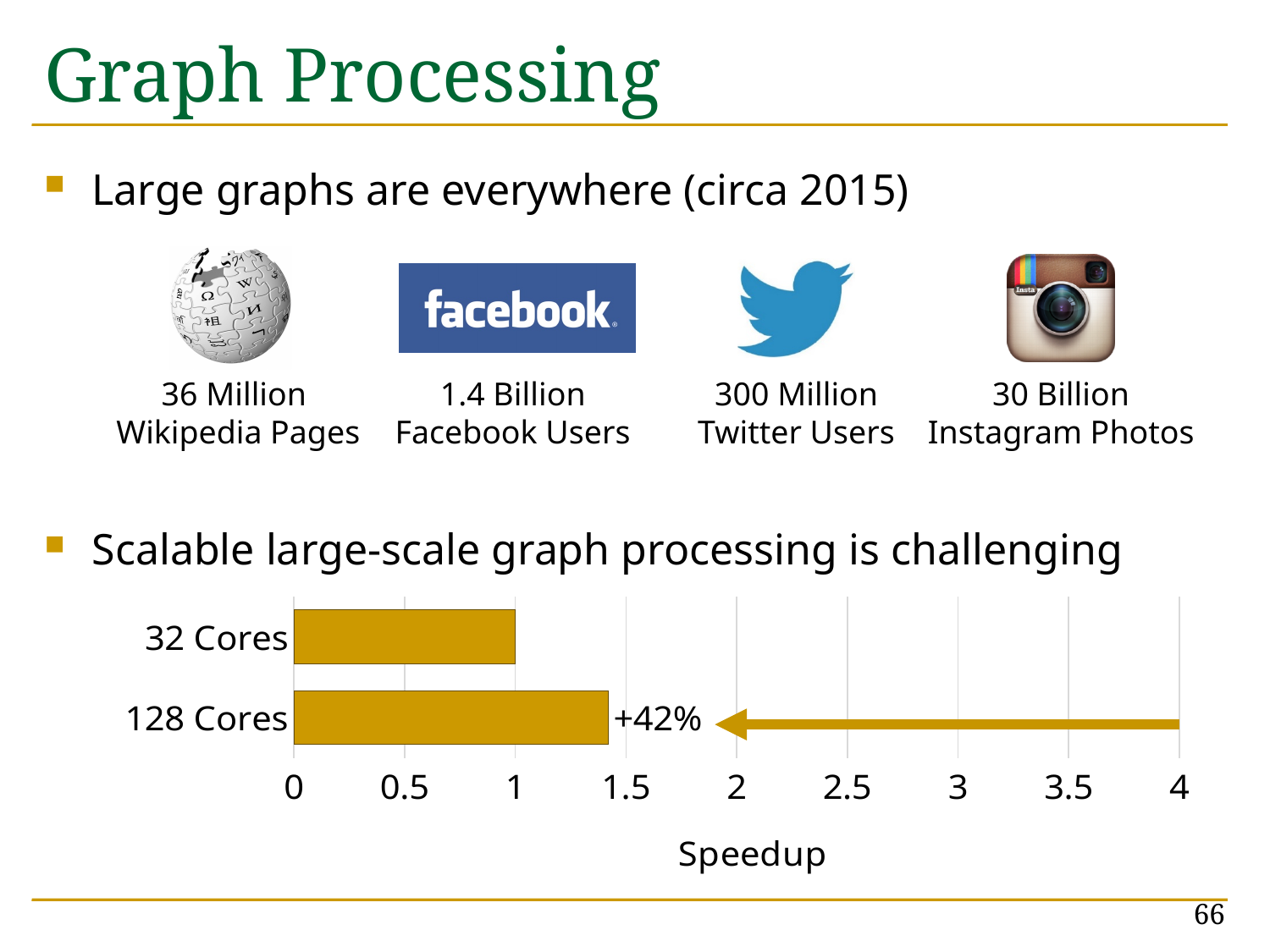
What annotation is printed next to the 128 Cores bar? +42% Is the speedup for 32 Cores greater or less than 2? less Which category has the higher speedup in the chart? 128 Cores Which is larger, the speedup for 128 Cores or for 32 Cores? 128 Cores What is the speedup value for 32 Cores? 1 How many categories are plotted in the Speedup chart? 2 Is the speedup for 128 Cores greater or less than 1.5? less What kind of chart is shown at the bottom of the slide? bar chart What is the title of the x axis in the chart? Speedup Which category has the lower speedup in the chart? 32 Cores Is the speedup for 128 Cores greater or less than 1? greater